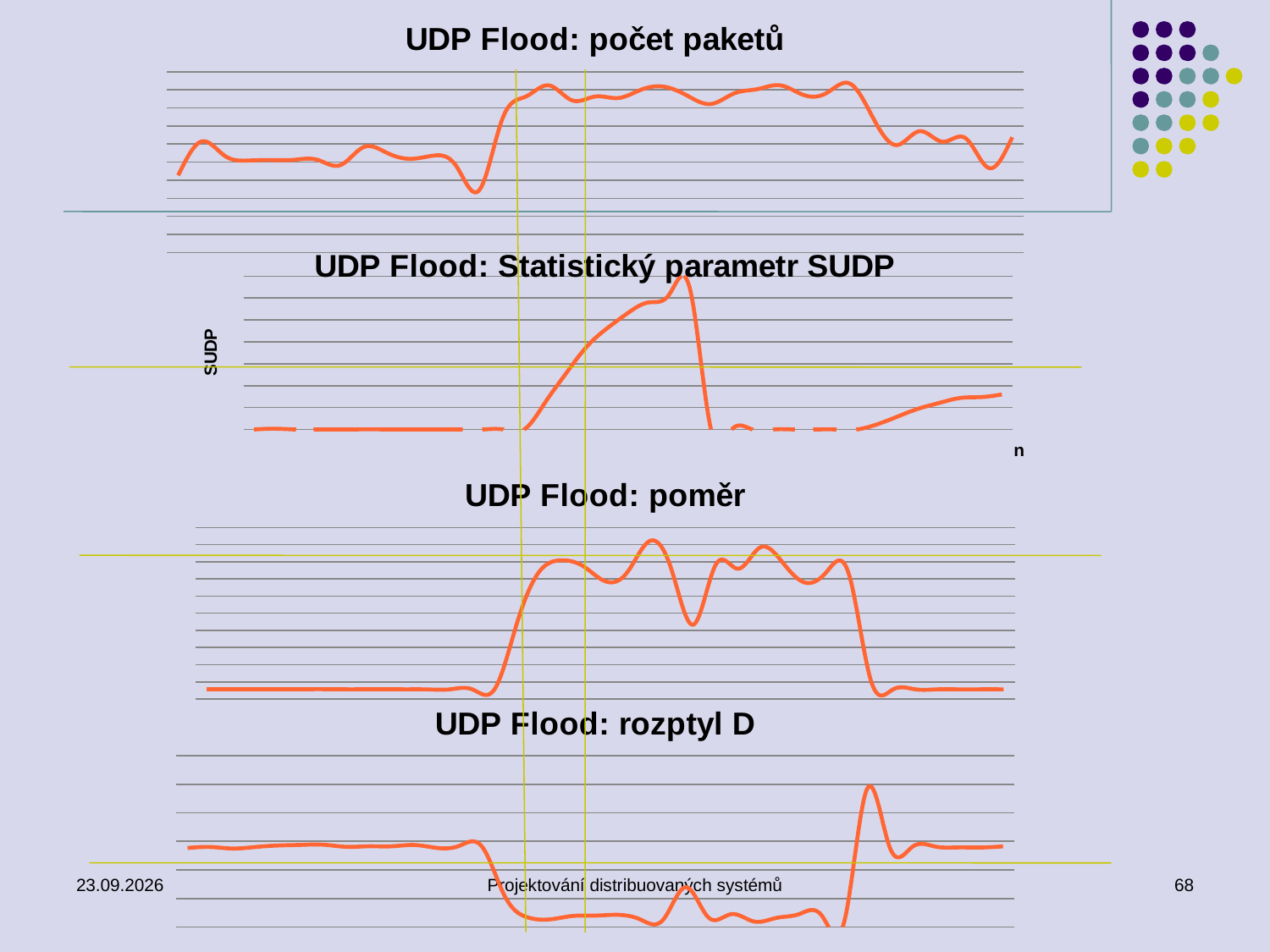
What kind of chart is 'UDP Flood: rozptyl D'? line chart What kind of chart is 'UDP Flood: poměr'? line chart In the 'UDP Flood: rozptyl D' chart, does the line rise or fall just after its flat left section? fall What kind of chart is 'UDP Flood: Statistický parametr SUDP'? line chart In the 'UDP Flood: počet paketů' chart, is the line higher in the middle section or at the far left? in the middle section In the 'UDP Flood: Statistický parametr SUDP' chart, does the line rise or fall immediately after reaching its peak? fall What is the label on the horizontal axis of the 'UDP Flood: Statistický parametr SUDP' chart? n What is the label on the vertical axis of the 'UDP Flood: Statistický parametr SUDP' chart? SUDP In the 'UDP Flood: poměr' chart, is the line higher at the far left or in the middle section? in the middle section